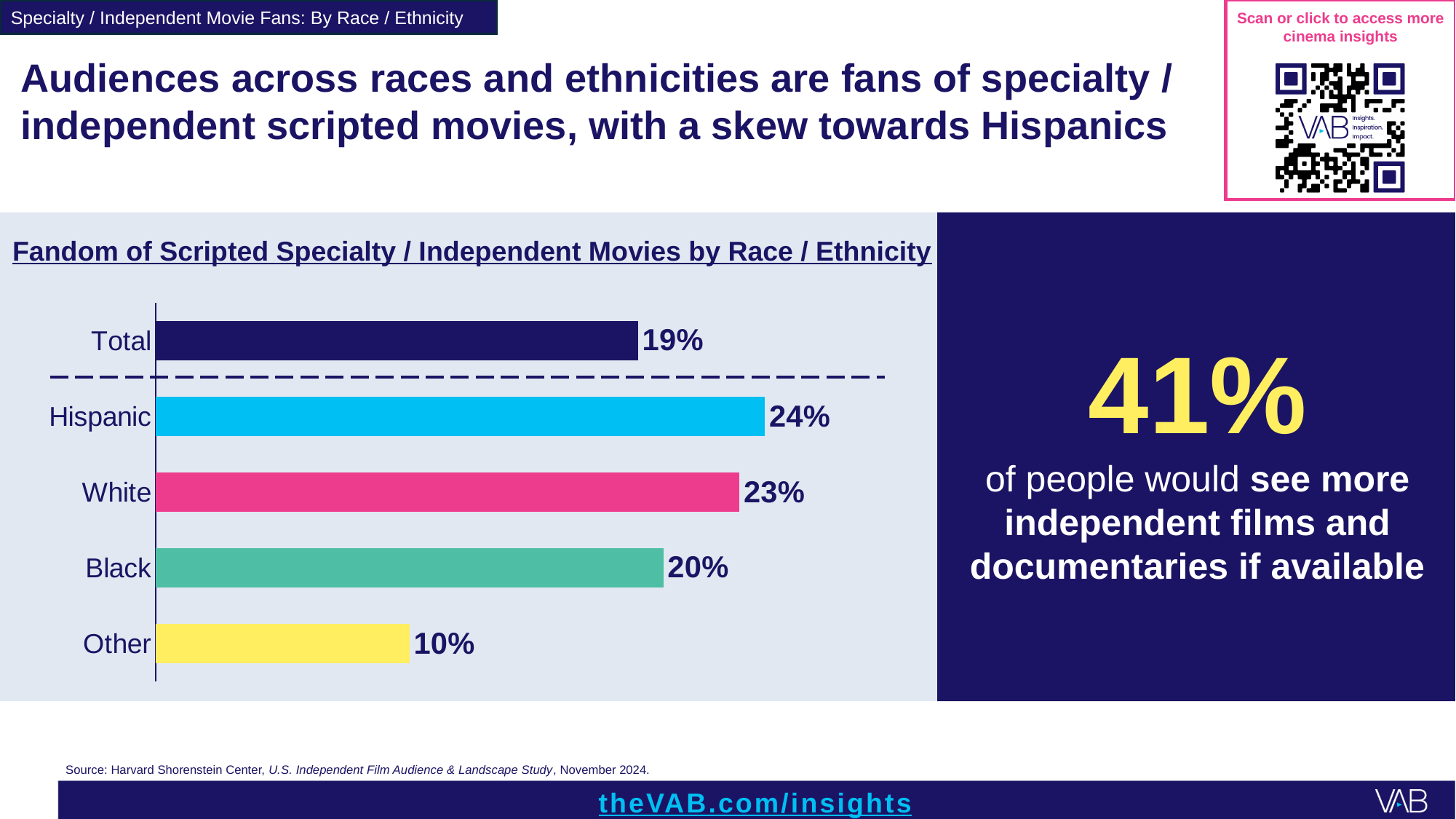
What is the difference between the Hispanic and White values? 1% What is the value for Other in the chart? 10% Which category has the lowest value in the chart? Other What is the difference between the Black and Other values? 10% Which is larger, the value for White or the value for Black? White What is the value for Total in the chart? 19% How many categories are shown in the chart? 5 What is the value for Hispanic in the chart? 24% Which race/ethnicity group has the highest fandom value? Hispanic What is the title of the chart? Fandom of Scripted Specialty / Independent Movies by Race / Ethnicity What kind of chart is shown on the slide? Bar chart What colour is the bar for Hispanic? Light blue